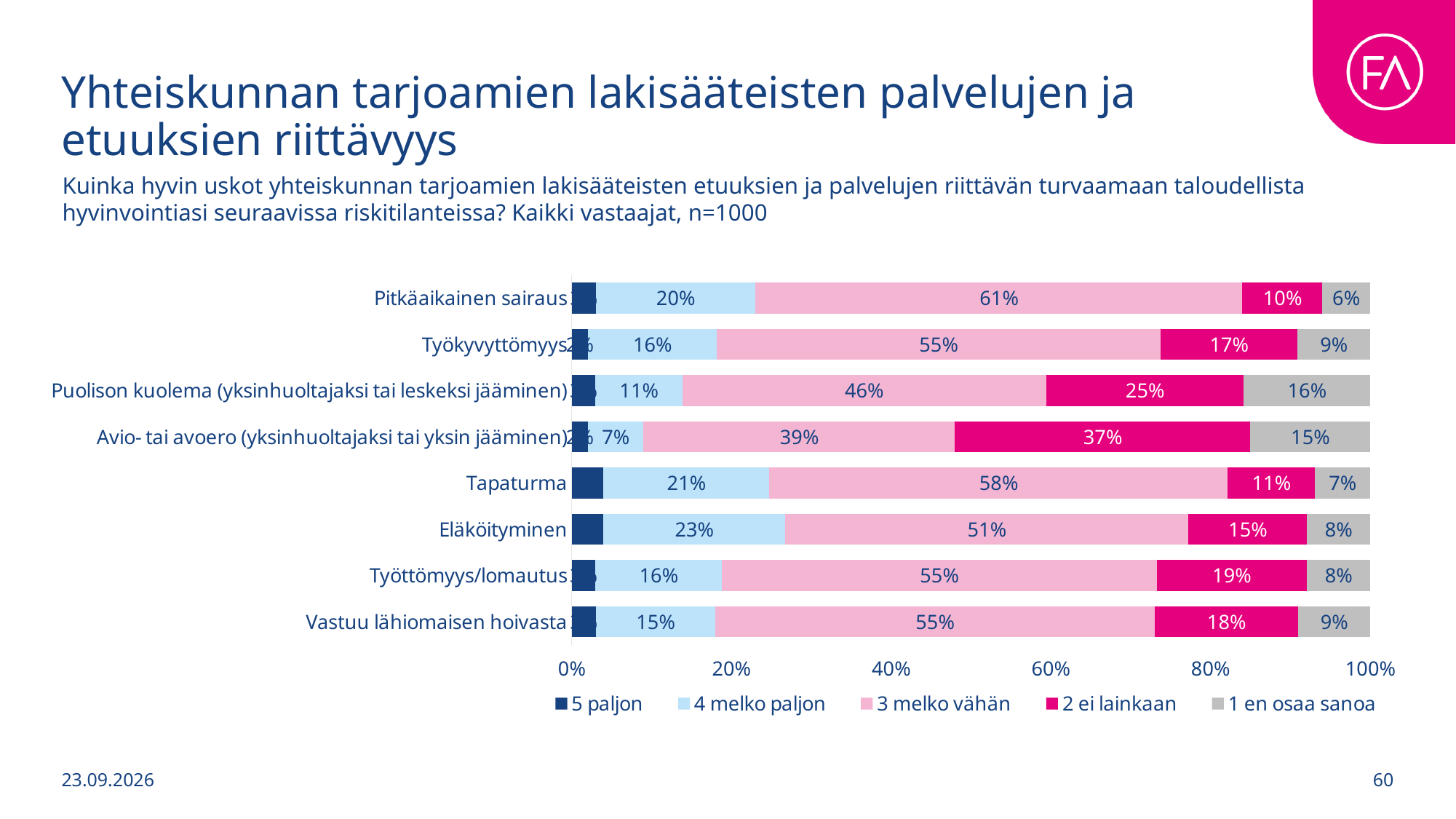
Which is larger: the '2 ei lainkaan' value for Työttömyys/lomautus or for Tapaturma? Työttömyys/lomautus What is the value of '2 ei lainkaan' for Avio- tai avoero (yksinhuoltajaksi tai yksin jääminen)? 37% What is the value of '3 melko vähän' for Pitkäaikainen sairaus? 61% What is the difference between the '3 melko vähän' values for Pitkäaikainen sairaus and Avio- tai avoero (yksinhuoltajaksi tai yksin jääminen)? 22% What kind of chart is shown on the slide? stacked bar chart Which category has the highest value for '2 ei lainkaan'? Avio- tai avoero (yksinhuoltajaksi tai yksin jääminen) What is the value of '1 en osaa sanoa' for Puolison kuolema (yksinhuoltajaksi tai leskeksi jääminen)? 16% How many categories (risk situations) are shown on the chart? 8 What is the value of '4 melko paljon' for Eläköityminen? 23% How many series does the legend list? 5 Which category has the lowest value for '4 melko paljon'? Avio- tai avoero (yksinhuoltajaksi tai yksin jääminen) Which legend entry is shown in grey? 1 en osaa sanoa